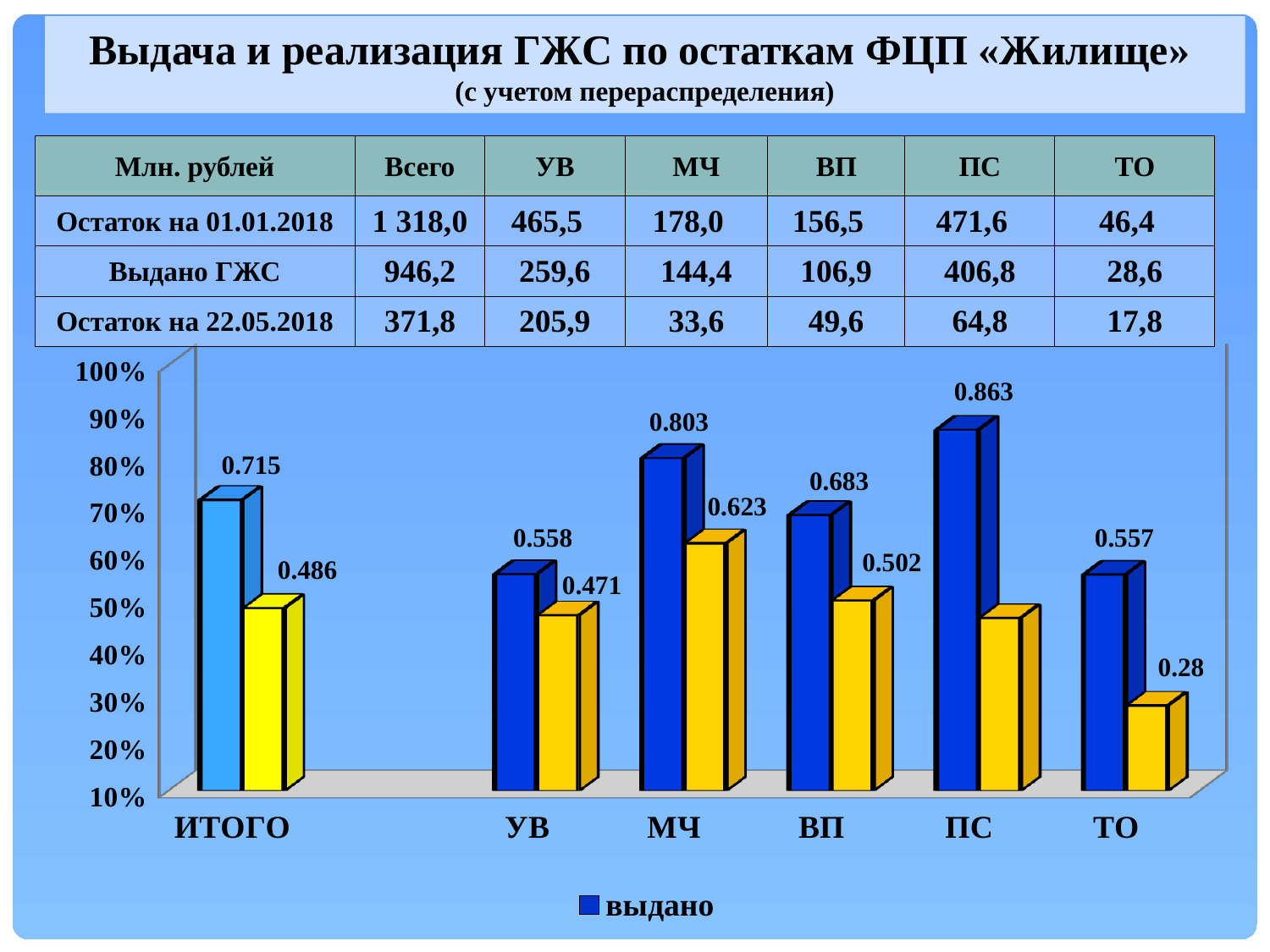
Which category has the highest выдано value? ПС What is the value of the yellow bar for ВП? 0.502 What is the value of the выдано bar for ИТОГО? 0.715 Is the yellow bar for ПС greater or less than 60%? less What is the difference between the blue and yellow bars for ИТОГО? 0.229 Which is larger, the выдано value for УВ or for ВП? ВП Which category has the lowest выдано value? ТО How many categories are shown on the x axis of the chart? 6 What type of chart is shown on the slide? bar chart What is the value of the выдано bar for МЧ? 0.803 What is the value of the yellow bar for ТО? 0.28 What is the difference between the blue and yellow bars for МЧ? 0.18